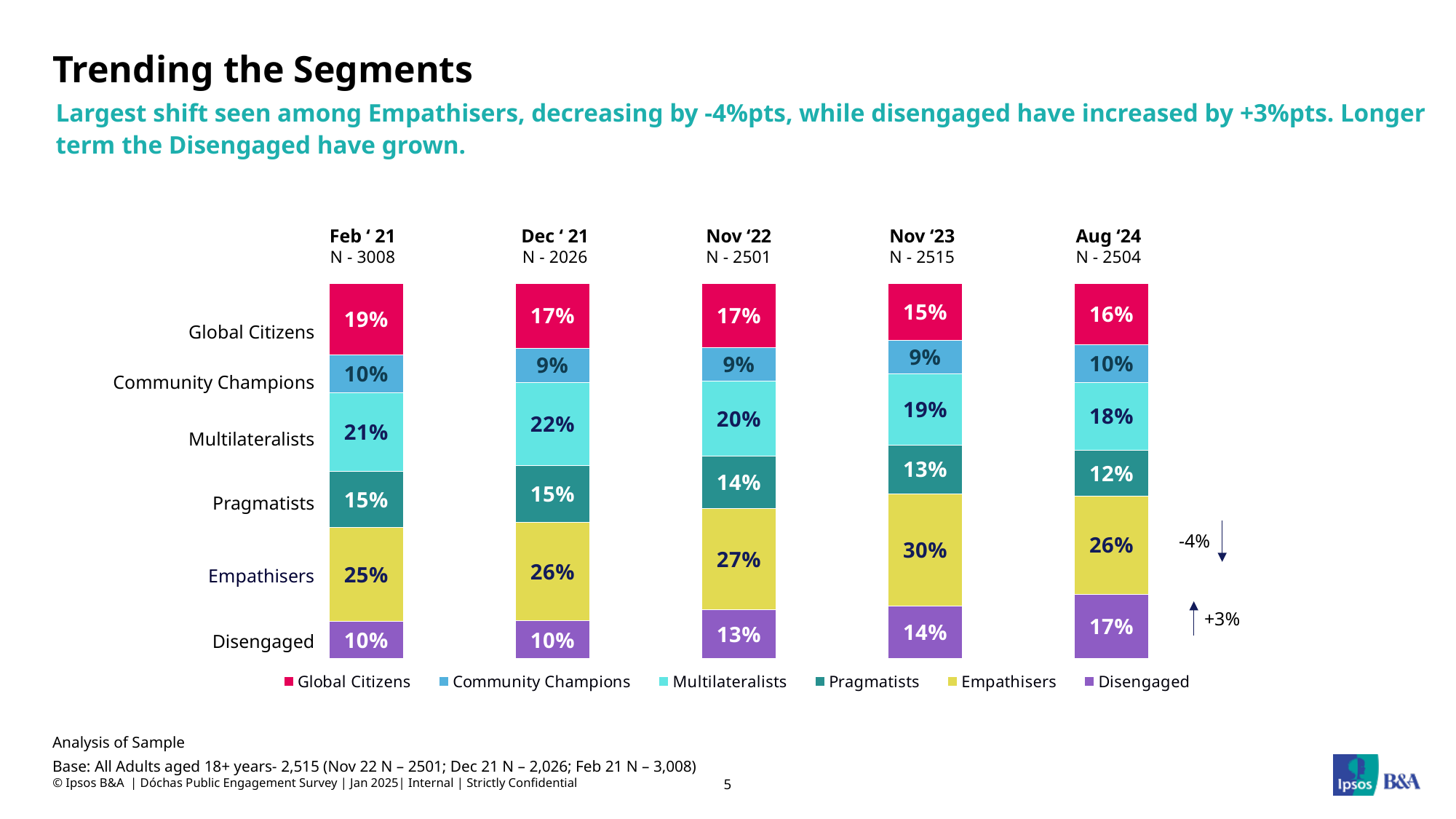
How many segments does the legend list? 6 How many survey waves (time periods) are shown in the chart? 5 Which segment has the smallest share in Nov '22? Community Champions Does the Disengaged share rise or fall from Feb '21 to Aug '24? Rises What is the value for Pragmatists in Dec '21? 15% What is the value for Disengaged in Aug '24? 17% What share were Global Citizens in Feb '21? 19% By how many percentage points did the Empathisers share change from Nov '23 to Aug '24? 4 percentage points (30% to 26%) What percentage of respondents were Empathisers in Nov '23? 30% Which segment has the largest share in Aug '24? Empathisers Is the Multilateralists share larger in Feb '21 or in Aug '24? Feb '21 What type of chart is shown on the slide? Stacked bar chart